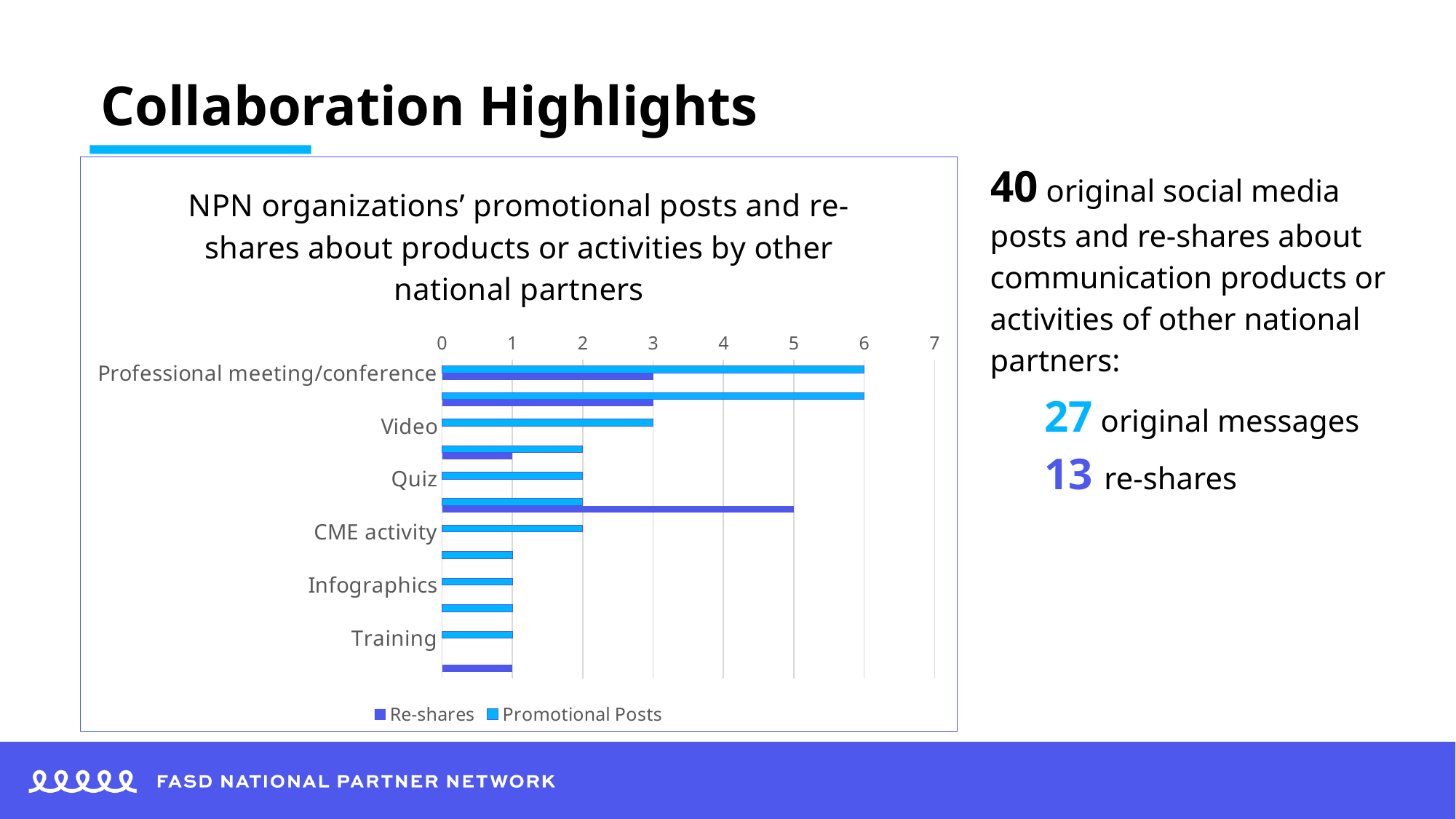
What are the two series named in the chart legend? Re-shares and Promotional Posts What is the Promotional Posts value for Training? 1 What is the Promotional Posts value for Video? 3 How many series does the chart legend list? 2 What kind of chart is shown on the slide? bar chart What is the highest value shown on the chart's value axis? 7 What is the difference between the Promotional Posts values for Professional meeting/conference and Video? 3 Which labeled category has the highest Promotional Posts value? Professional meeting/conference What is the Promotional Posts value for Professional meeting/conference? 6 Is the Promotional Posts value for Professional meeting/conference greater or less than 5? greater Which is larger, the Promotional Posts value for Professional meeting/conference or for Video? Professional meeting/conference What is the Re-shares value for Professional meeting/conference? 3